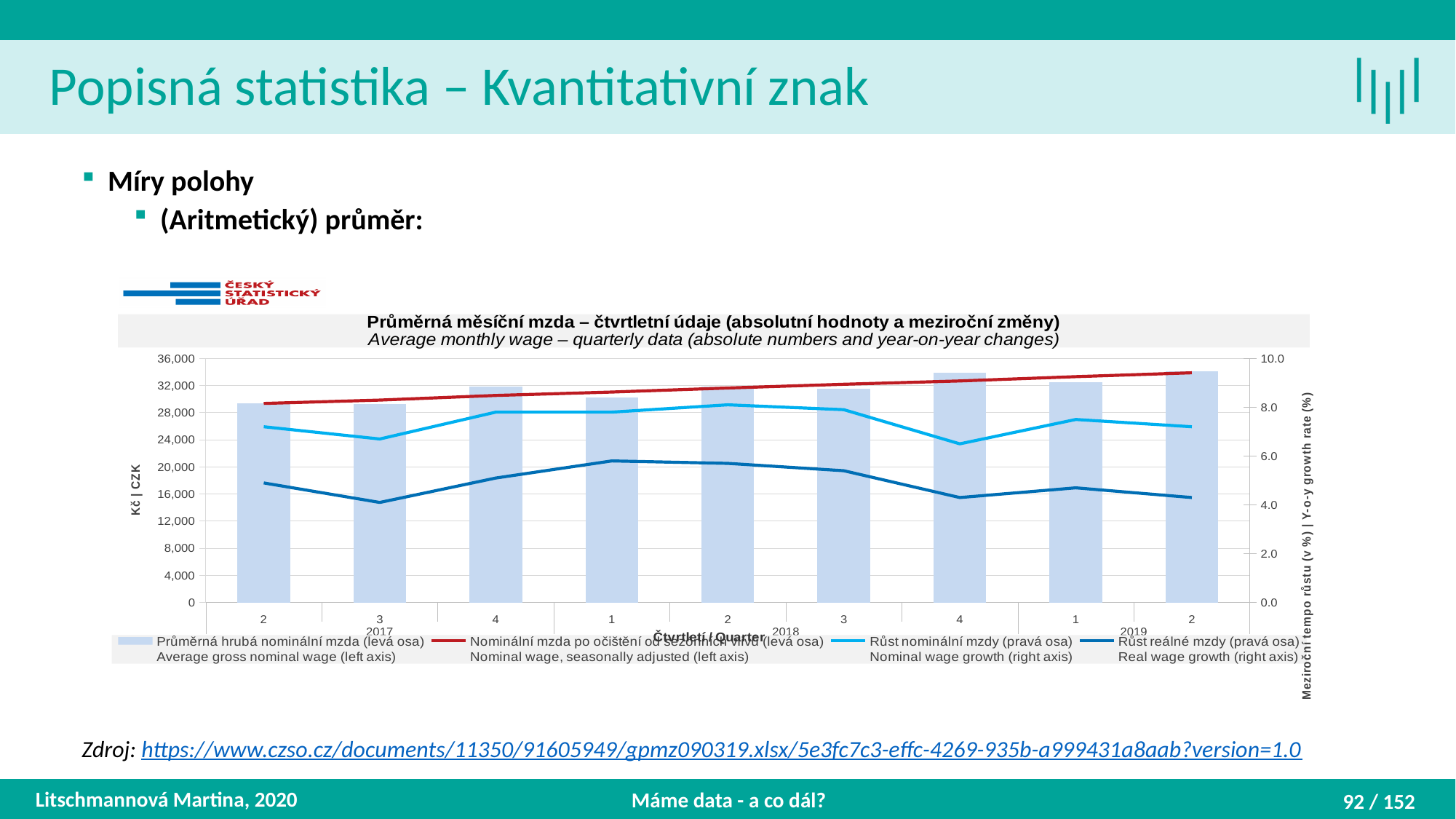
Is the nominal wage growth value for quarter 4 of 2017 greater or less than 6.0? greater How many series does the chart legend list? 4 Does the seasonally adjusted nominal wage line rise or fall from quarter 2 of 2017 to quarter 2 of 2019? Rises In which quarter does the real wage growth line reach its highest value? Quarter 1 of 2018 What kind of chart is shown on the slide? A combination of a bar chart and line chart How many quarterly bars are plotted in the chart? 9 Is the average gross nominal wage bar for quarter 2 of 2019 greater or less than 32,000? greater Is the average gross nominal wage bar for quarter 3 of 2017 greater or less than 32,000? less What is the label of the left vertical axis of the chart? Kč | CZK At quarter 1 of 2018, which is larger: nominal wage growth or real wage growth? Nominal wage growth What colour is the line for the seasonally adjusted nominal wage in the chart? Red